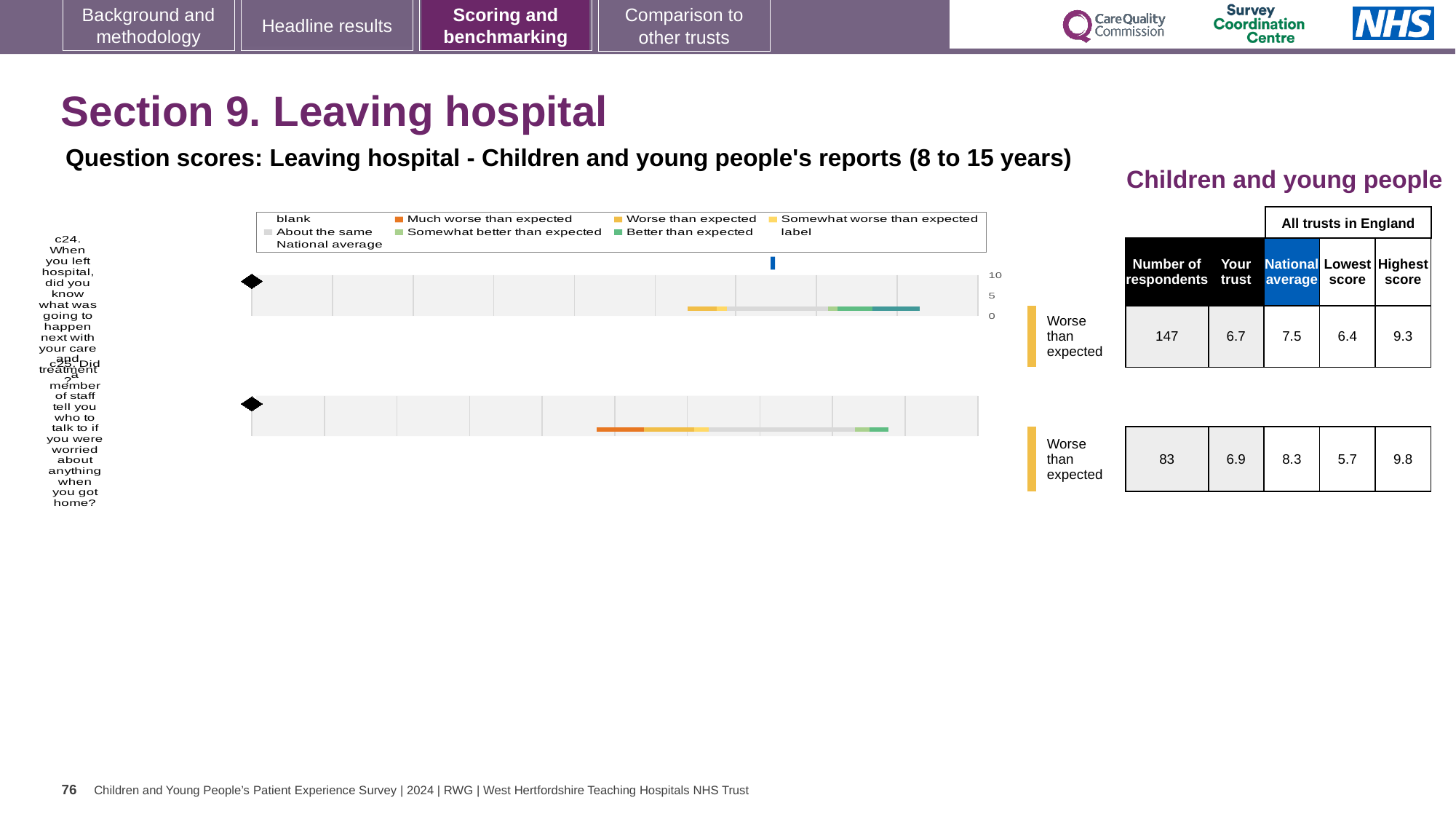
For question c24, which is larger: the 'Your trust' score or the national average? National average How many questions are charted on this slide? 2 For question c24, what is the difference between the highest score (9.3) and the lowest score (6.4)? 2.9 Which question has more respondents, c24 or c25? c24 For question c24 (When you left hospital, did you know what was going to happen next), what is the 'Your trust' score? 6.7 For question c25, what is the highest score among all trusts in England? 9.8 What kind of chart is used to show the benchmarking for question c24? bar chart For question c25, what is the difference between the national average (8.3) and the 'Your trust' score (6.9)? 1.4 For question c24, what is the national average score? 7.5 For question c25 (Did a member of staff tell you who to talk to if you were worried), how many respondents are there? 83 What benchmark category is shown next to the chart for question c25? Worse than expected In the chart legend, what colour represents 'Much worse than expected'? Orange